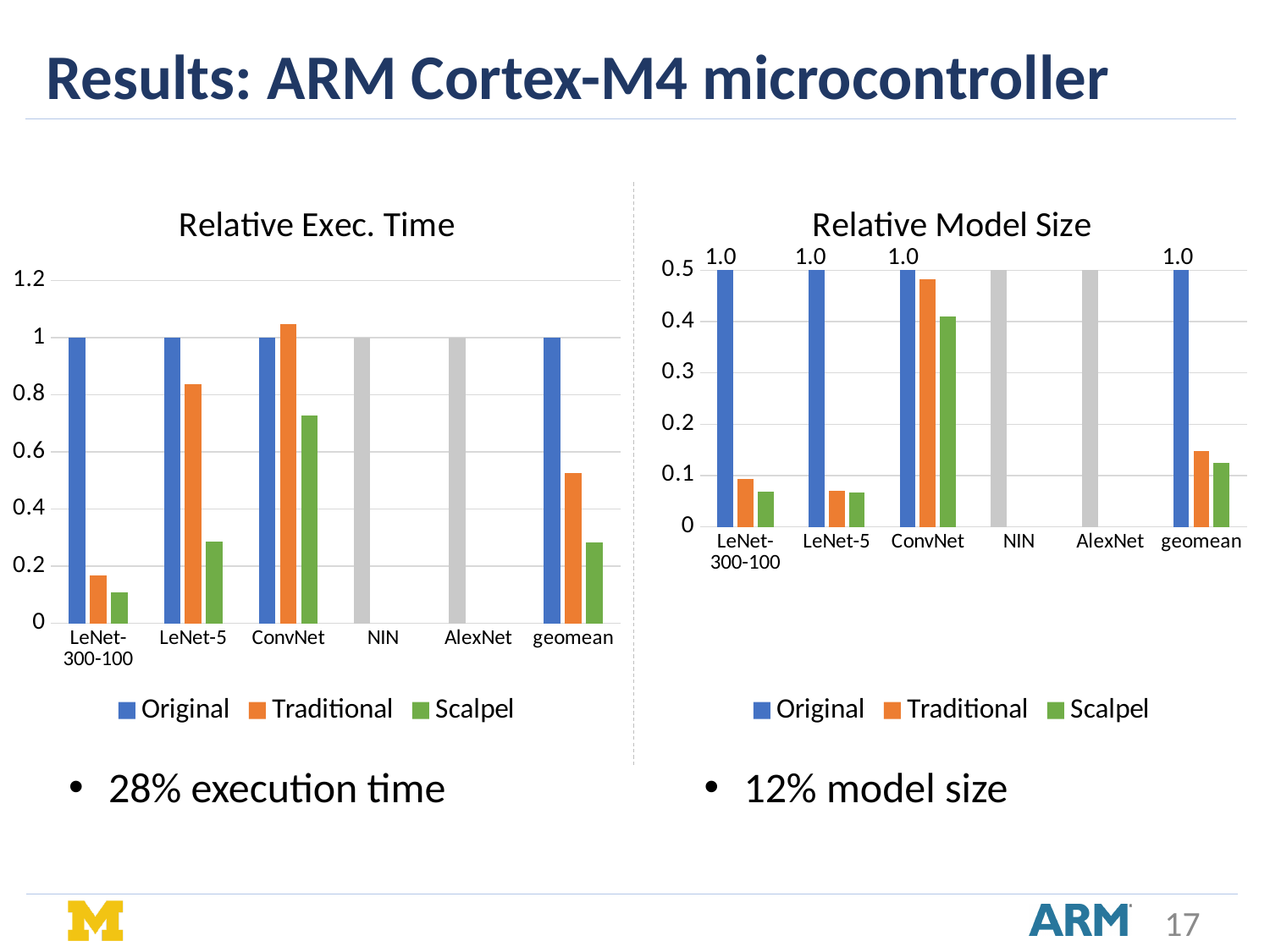
In the Relative Exec. Time chart, is the Scalpel value for LeNet-300-100 greater or less than 0.2? less In the Relative Model Size chart, what is the Original value for ConvNet? 1.0 In the Relative Exec. Time chart, which is larger for ConvNet, Traditional or Scalpel? Traditional In the Relative Exec. Time chart, which category has the lowest Scalpel value? LeNet-300-100 In the Relative Model Size chart, which is larger for ConvNet, Traditional or Scalpel? Traditional How many series does the legend of the Relative Model Size chart list? 3 How many categories are shown on the x axis of the Relative Exec. Time chart? 6 In the Relative Exec. Time chart, which category has the highest Scalpel value? ConvNet In the Relative Model Size chart, is the Traditional value for geomean greater or less than 0.2? less In the Relative Exec. Time chart, what is the Original value for LeNet-5? 1 In the Relative Exec. Time chart, is the Traditional value for LeNet-5 greater or less than 0.6? greater What kind of chart is the Relative Exec. Time chart? bar chart